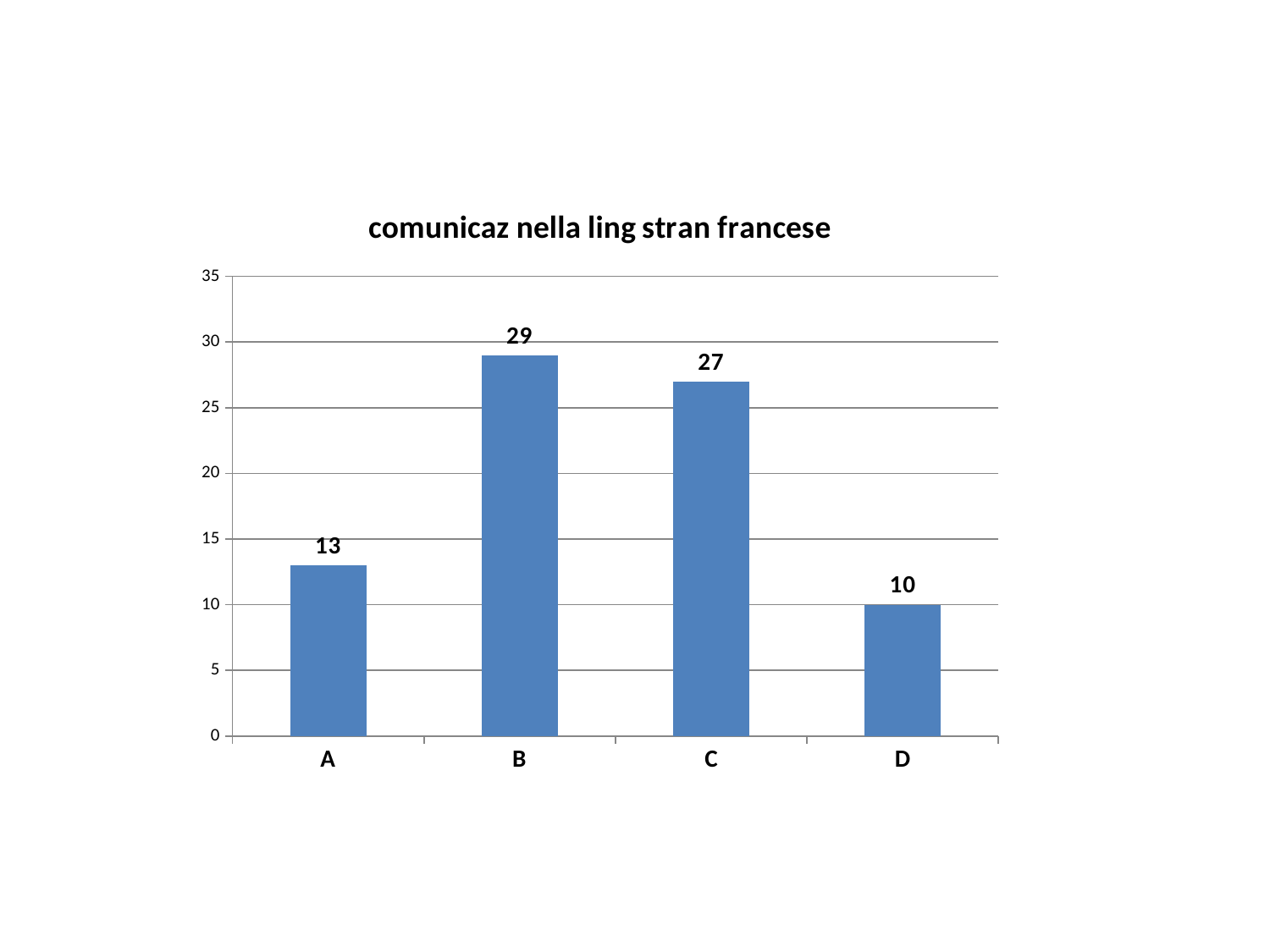
What is the value for category C? 27 What is the value for category A? 13 How many categories are shown on the x axis? 4 Which category has the lowest value? D What is the difference between the values for A and D? 3 What is the value for category B? 29 Which category has the highest value? B What is the difference between the values for B and C? 2 What is the value for category D? 10 What kind of chart is shown on the slide? bar chart Is the value for B greater or less than 25? greater Which is larger, the value for A or the value for C? C